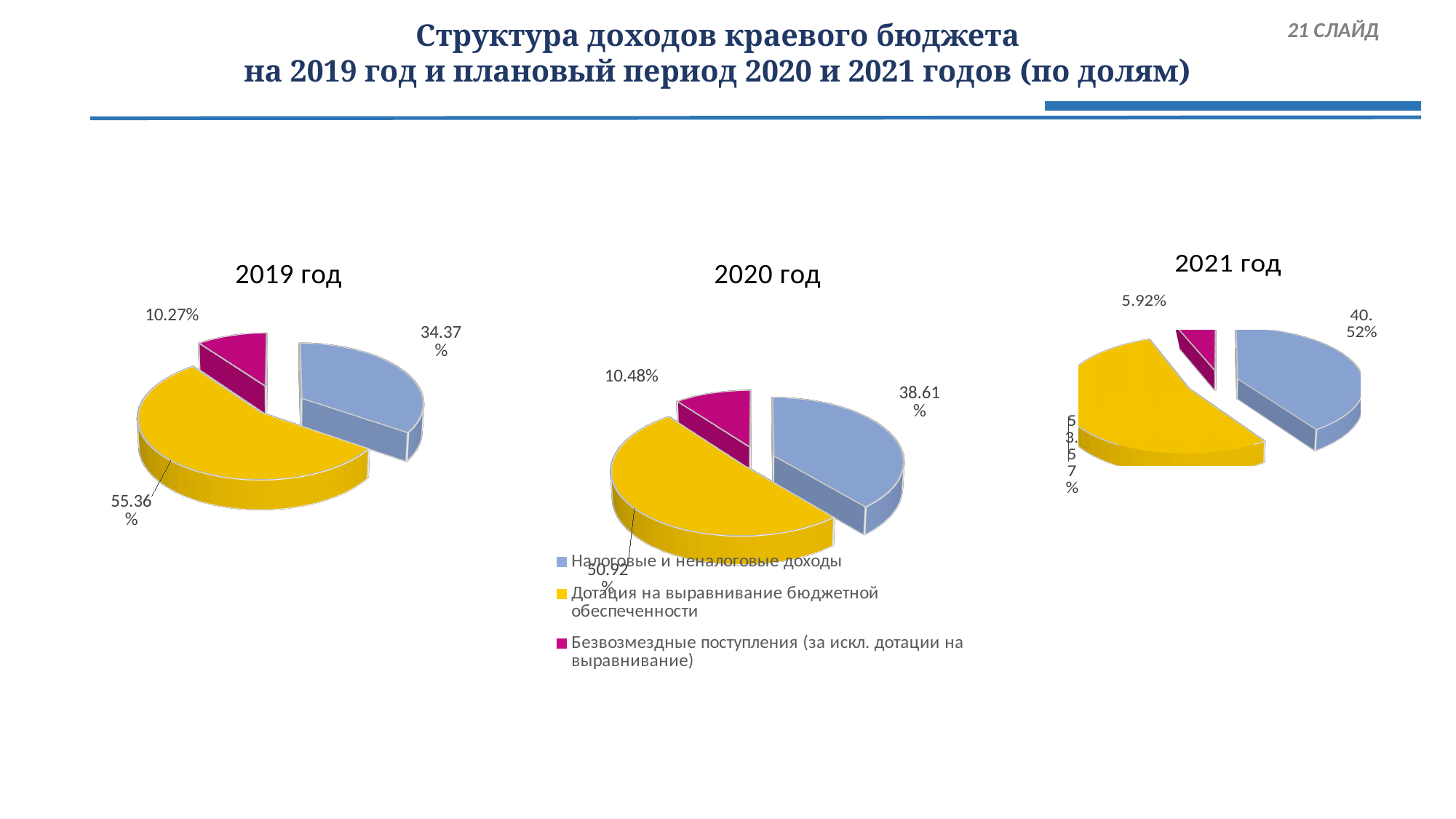
In the 2019 год chart, what share is shown for Налоговые и неналоговые доходы (blue slice)? 34.37% In the 2021 год chart, what share is shown for Налоговые и неналоговые доходы (blue slice)? 40.52% In the 2019 год chart, what share is shown for Дотация на выравнивание бюджетной обеспеченности (yellow slice)? 55.36% In the 2020 год chart, what share is shown for Безвозмездные поступления (за искл. дотации на выравнивание) (magenta slice)? 10.48% How many entries does the legend list? 3 What kind of chart is used for 2019 год? Pie chart How many slices does the 2021 год chart have? 3 In the 2020 год chart, what is the difference between the shares of Дотация на выравнивание бюджетной обеспеченности and Налоговые и неналоговые доходы? 12.31% In the 2019 год chart, which category has the smallest share? Безвозмездные поступления (за искл. дотации на выравнивание) Which is larger: the share of Налоговые и неналоговые доходы in 2019 год or in 2020 год? 2020 год In the 2021 год chart, what share is shown for Безвозмездные поступления (за искл. дотации на выравнивание) (magenta slice)? 5.92% In the 2020 год chart, which category has the largest share? Дотация на выравнивание бюджетной обеспеченности